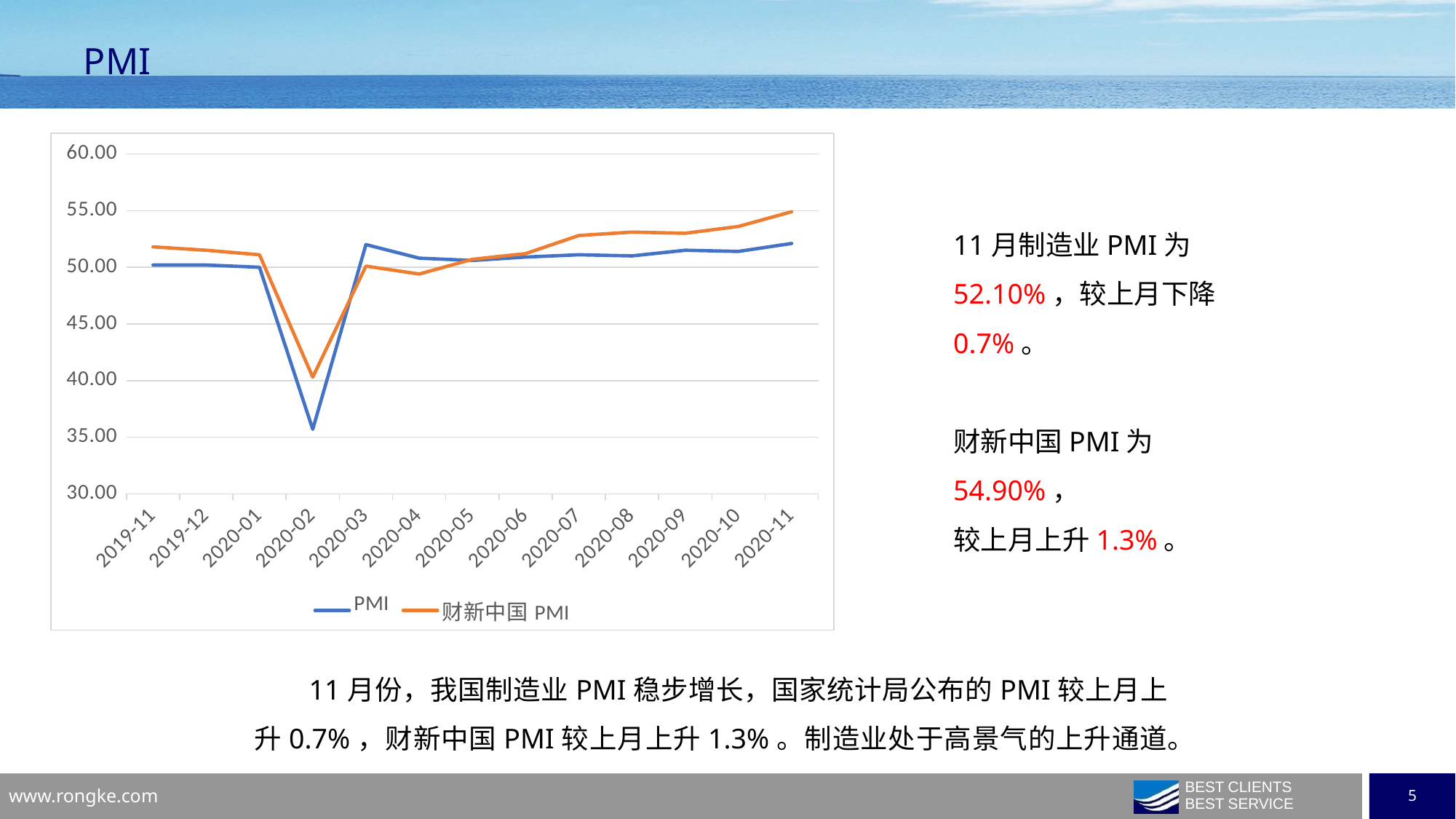
In which month does the 财新中国 PMI series reach its lowest value? 2020-02 How many series does the chart legend list? 2 In which month does the PMI series reach its lowest value? 2020-02 Is the value of the PMI series for 2020-02 greater or less than 40.00? less How many months are plotted along the x axis of the chart? 13 Is the value of the 财新中国 PMI series for 2020-02 greater or less than 45.00? less Is the value of the 财新中国 PMI series for 2020-07 greater or less than 50.00? greater What kind of chart is shown on the slide? line chart In 2020-11, which series has the higher value, PMI or 财新中国 PMI? 财新中国 PMI Does the 财新中国 PMI series rise or fall from 2020-02 to 2020-11? rise In which month does the 财新中国 PMI series reach its highest value? 2020-11 In 2020-04, which series has the higher value, PMI or 财新中国 PMI? PMI